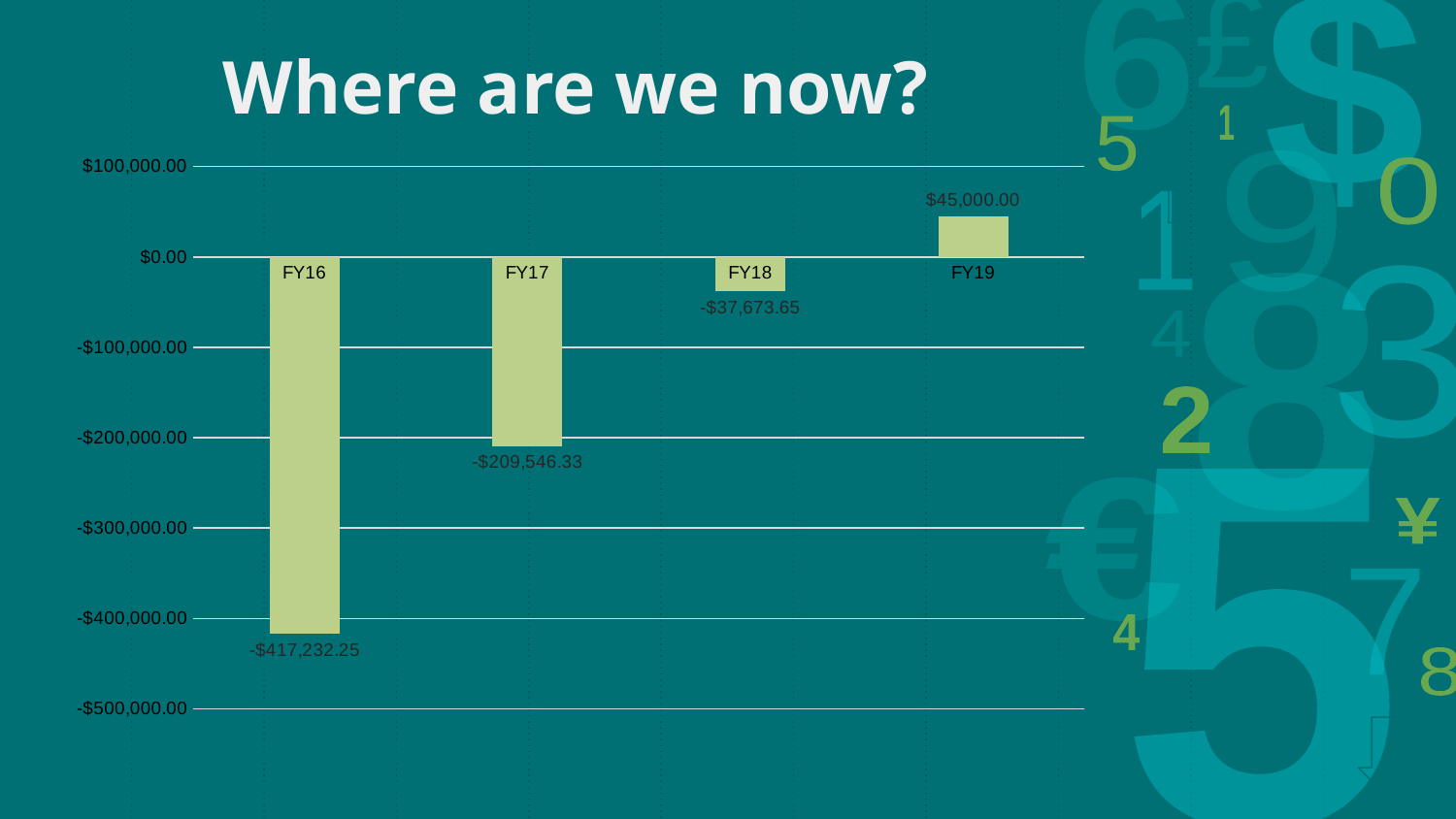
Which fiscal year has the highest value? FY19 What is the value for FY19? $45,000.00 What is the difference between the FY17 value and the FY16 value? $207,685.92 Do the values rise or fall from FY16 to FY19? Rise What is the value for FY17? -$209,546.33 How many fiscal years are shown on the chart? 4 Which is larger, the value for FY17 or the value for FY18? FY18 What is the value for FY18? -$37,673.65 What kind of chart is shown on the slide? Bar chart What is the value for FY16? -$417,232.25 What is the difference between the FY19 value and the FY18 value? $82,673.65 Which fiscal year has the lowest value? FY16